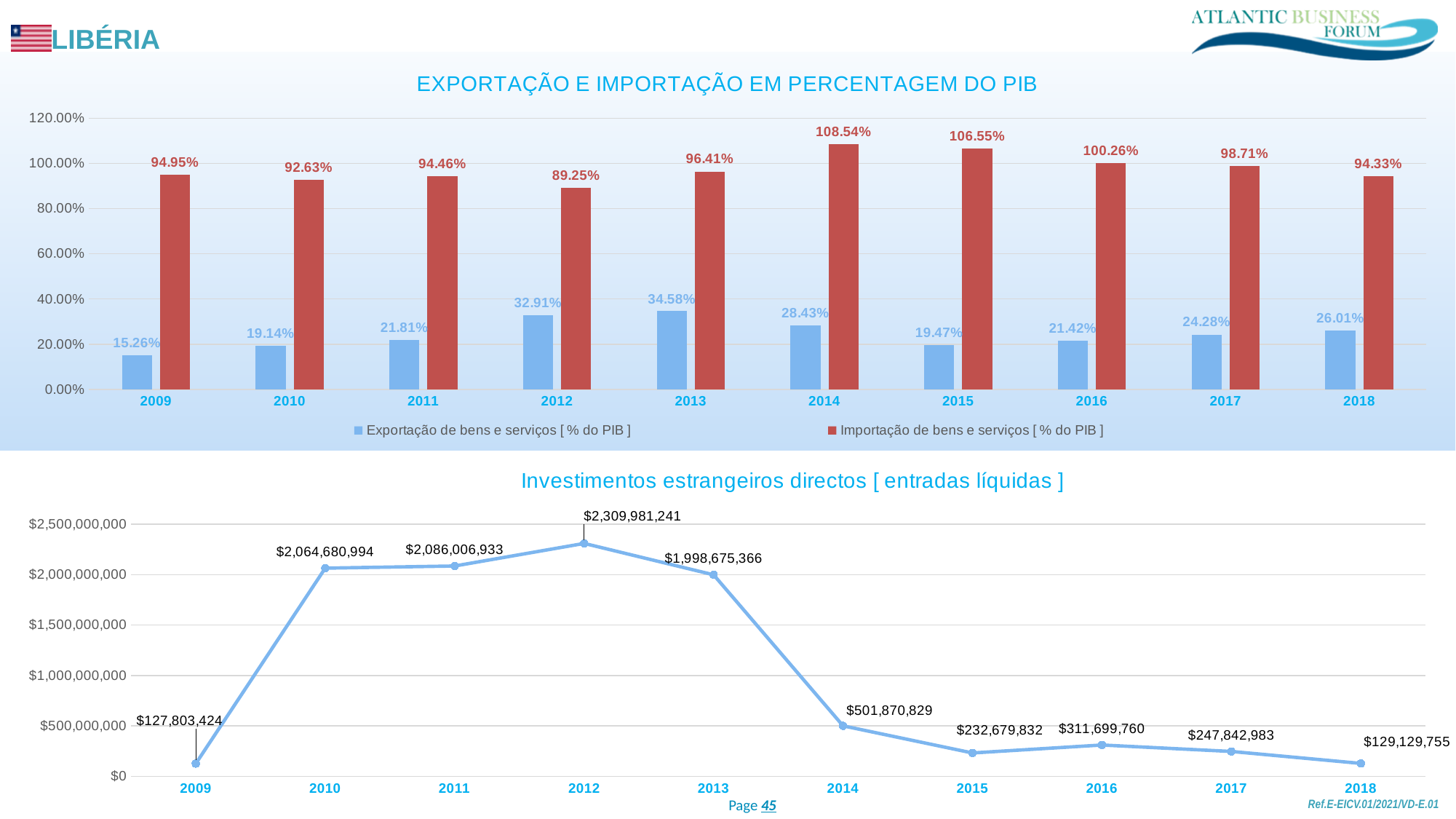
What kind of chart is the 'Investimentos estrangeiros directos [ entradas líquidas ]' chart? Line chart In the 'EXPORTAÇÃO E IMPORTAÇÃO EM PERCENTAGEM DO PIB' chart, what is the value of Importação de bens e serviços for 2012? 89.25% In the 'Investimentos estrangeiros directos [ entradas líquidas ]' chart, how many data points are plotted? 10 In the 'EXPORTAÇÃO E IMPORTAÇÃO EM PERCENTAGEM DO PIB' chart, how many series does the legend list? 2 In the 'Investimentos estrangeiros directos [ entradas líquidas ]' chart, which year has the lowest value? 2009 In the 'Investimentos estrangeiros directos [ entradas líquidas ]' chart, what is the value for 2012? $2,309,981,241 In the 'EXPORTAÇÃO E IMPORTAÇÃO EM PERCENTAGEM DO PIB' chart, which year has the lowest Exportação de bens e serviços value? 2009 In the 'Investimentos estrangeiros directos [ entradas líquidas ]' chart, which is larger: the value for 2015 or the value for 2016? 2016 In the 'EXPORTAÇÃO E IMPORTAÇÃO EM PERCENTAGEM DO PIB' chart, which year has the highest Importação de bens e serviços value? 2014 What kind of chart is the 'EXPORTAÇÃO E IMPORTAÇÃO EM PERCENTAGEM DO PIB' chart? Bar chart In the 'EXPORTAÇÃO E IMPORTAÇÃO EM PERCENTAGEM DO PIB' chart, what is the difference between Importação and Exportação in 2018? 68.32% In the 'EXPORTAÇÃO E IMPORTAÇÃO EM PERCENTAGEM DO PIB' chart, what is the value of Exportação de bens e serviços for 2013? 34.58%